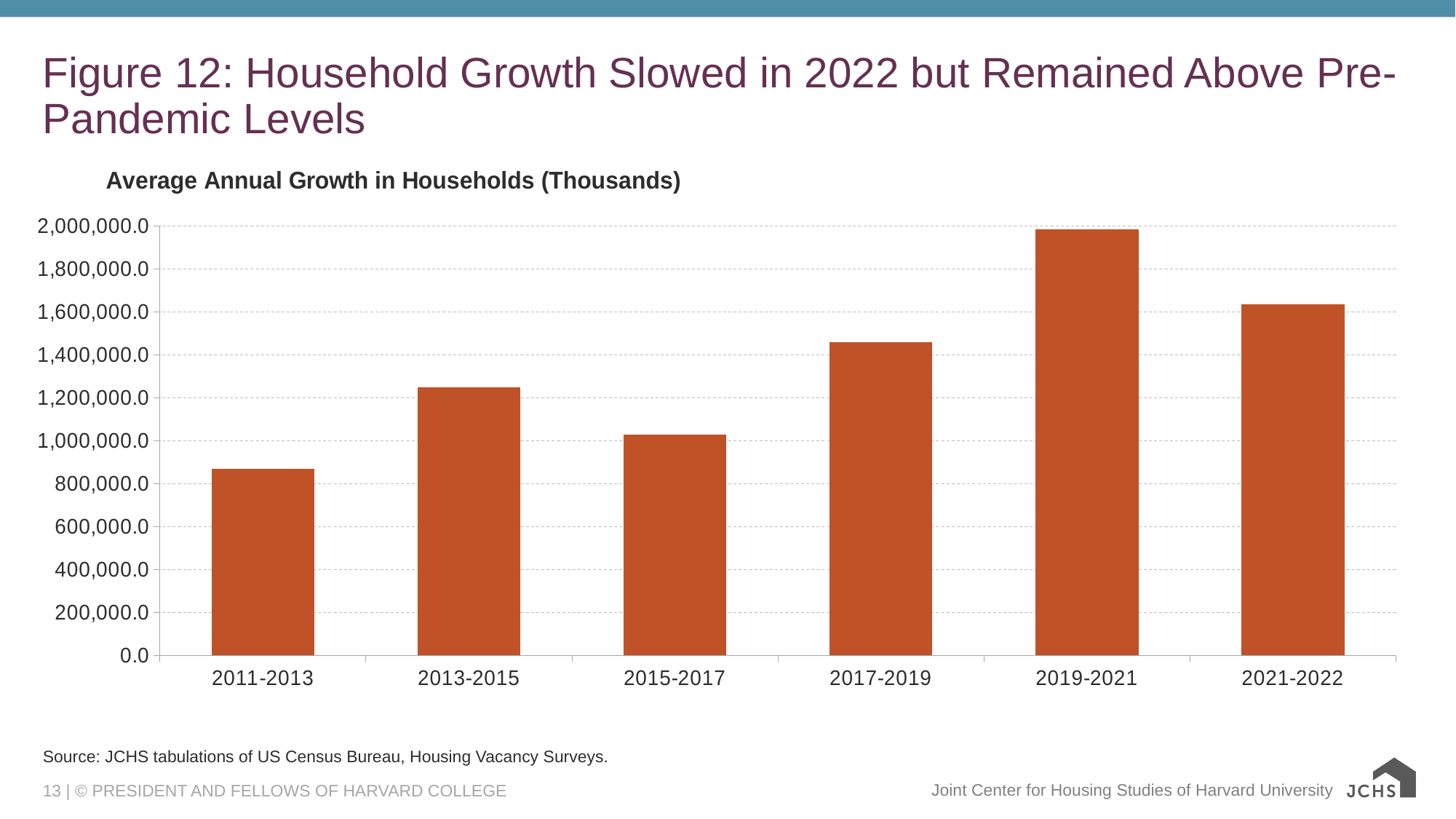
Is the value for 2017-2019 greater or less than 1,400,000.0? greater Which period has the lowest average annual growth in households? 2011-2013 What kind of chart is shown on the slide? bar chart Did the average annual growth in households rise or fall from 2019-2021 to 2021-2022? fall Is the value for 2011-2013 greater or less than 1,000,000.0? less Which period has the larger value, 2013-2015 or 2015-2017? 2013-2015 Which period has the highest average annual growth in households? 2019-2021 Is the value for 2019-2021 greater or less than 1,800,000.0? greater How many periods are shown on the x axis of the chart? 6 What is the title shown above the chart? Average Annual Growth in Households (Thousands)